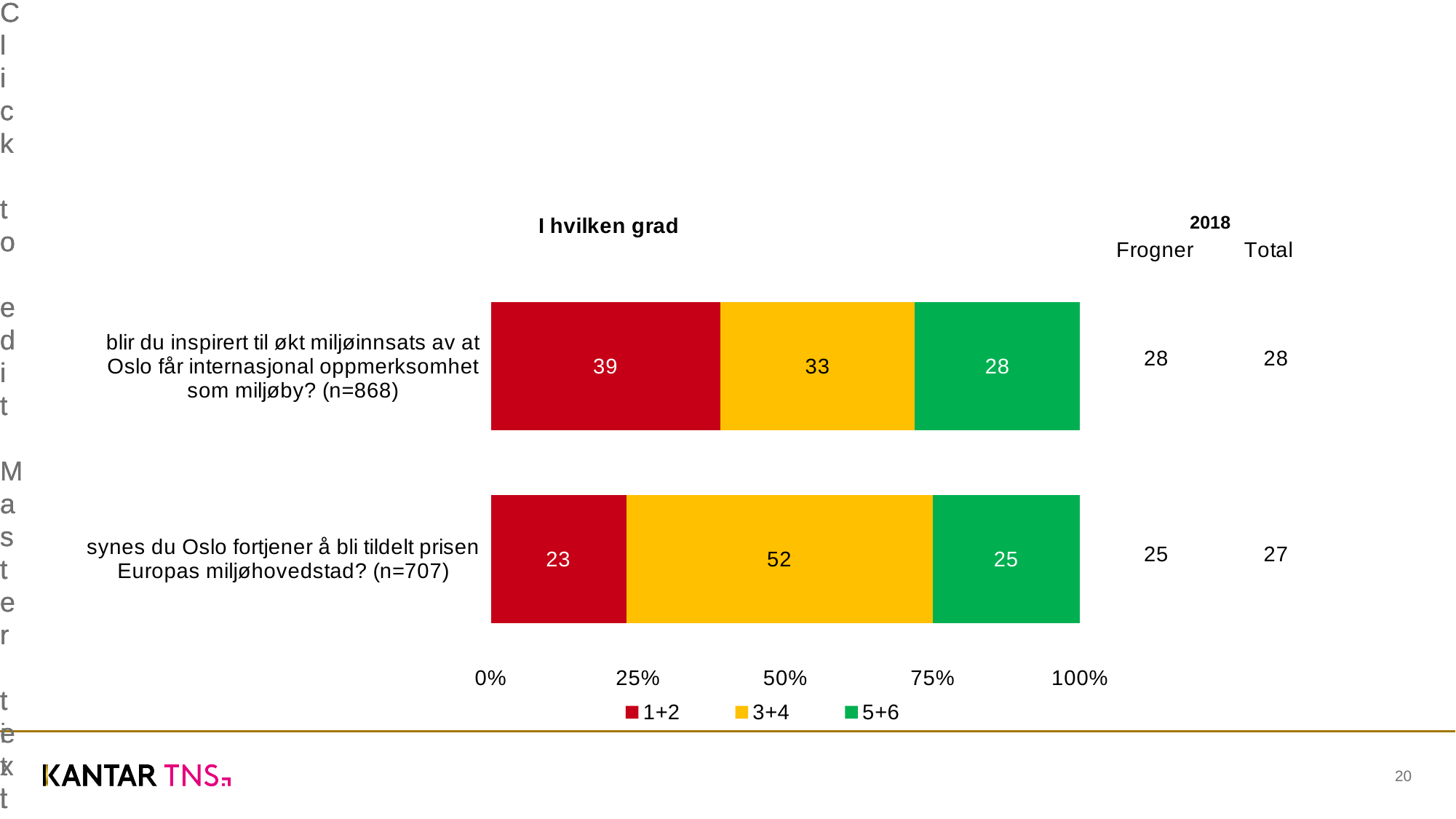
What is the value of the 5+6 series for "synes du Oslo fortjener å bli tildelt prisen Europas miljøhovedstad? (n=707)"? 25 What is the value of the 1+2 series for "blir du inspirert til økt miljøinnsats av at Oslo får internasjonal oppmerksomhet som miljøby? (n=868)"? 39 What is the value of the 3+4 series for "synes du Oslo fortjener å bli tildelt prisen Europas miljøhovedstad? (n=707)"? 52 Is the 1+2 value larger for "blir du inspirert til økt miljøinnsats..." (n=868) or for "synes du Oslo fortjener å bli tildelt prisen Europas miljøhovedstad?" (n=707)? blir du inspirert til økt miljøinnsats av at Oslo får internasjonal oppmerksomhet som miljøby? (n=868) How many series does the legend list? 3 What is the difference between the 1+2 values of the two bars (39 and 23)? 16 Which series has the smallest value in the bar for "blir du inspirert til økt miljøinnsats av at Oslo får internasjonal oppmerksomhet som miljøby? (n=868)"? 5+6 What is the title of the chart? I hvilken grad Which series has the largest value in the bar for "synes du Oslo fortjener å bli tildelt prisen Europas miljøhovedstad? (n=707)"? 3+4 How many bars (categories) does the chart show? 2 What is the total of the stacked bar for "blir du inspirert til økt miljøinnsats av at Oslo får internasjonal oppmerksomhet som miljøby? (n=868)"? 100 What kind of chart is shown on the slide? Stacked bar chart